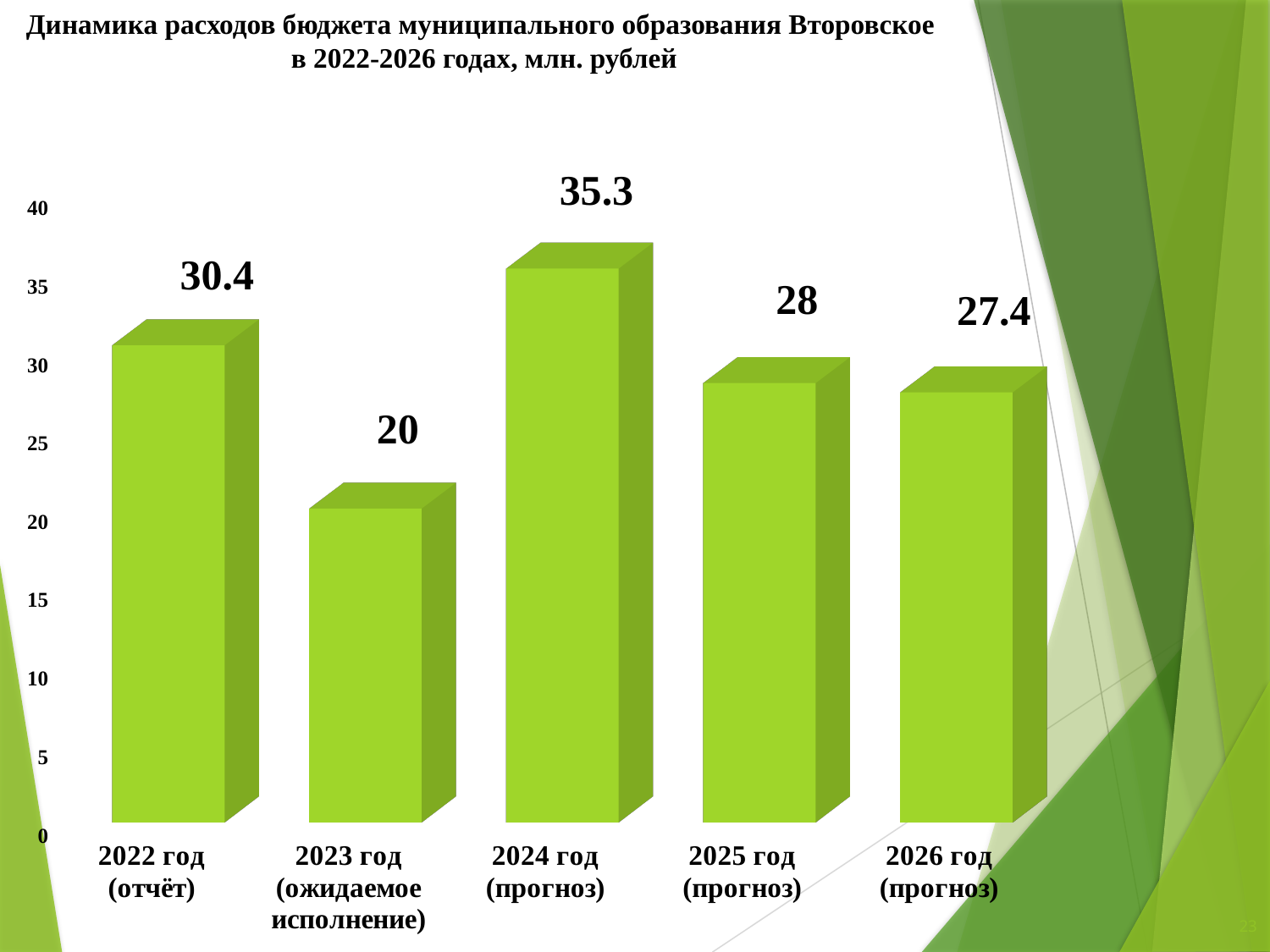
What is the value for 2023 год (ожидаемое исполнение)? 20 What is the value for 2024 год (прогноз)? 35.3 What kind of chart is shown on the slide? bar chart What is the title of the chart? Динамика расходов бюджета муниципального образования Второвское в 2022-2026 годах, млн. рублей Which year has the lowest value? 2023 год (ожидаемое исполнение) Is the value for 2022 год greater or less than 25? greater What is the value for 2022 год (отчёт)? 30.4 Which is larger, the value for 2025 год or the value for 2026 год? 2025 год What is the difference between the values for 2024 год and 2023 год? 15.3 What is the value for 2026 год (прогноз)? 27.4 Which year has the highest value? 2024 год (прогноз) How many years are shown on the chart? 5